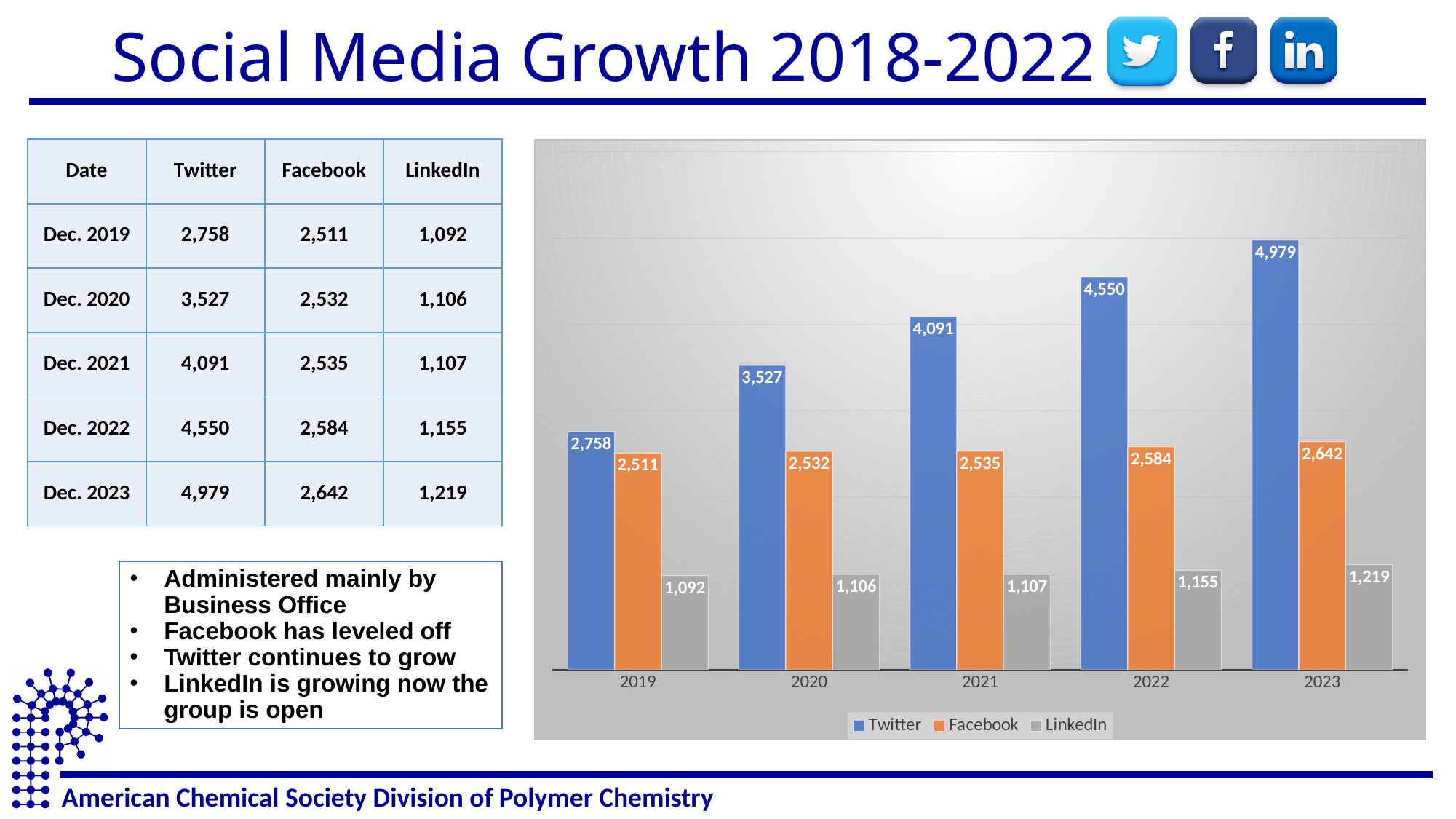
What is the Facebook value for 2020 in the chart? 2,532 Which series is shown in orange in the chart? Facebook How many series does the chart legend list? 3 In which year is the Twitter value highest? 2023 What is the LinkedIn value for 2022 in the chart? 1,155 What is the difference between the Twitter values for 2023 and 2019? 2,221 How many years are shown on the x axis of the chart? 5 Which is larger in 2021, the Twitter value or the Facebook value? Twitter In which year is the LinkedIn value lowest? 2019 Do the Twitter values rise or fall from 2019 to 2023? Rise What kind of chart is shown on the slide? Bar chart What is the Twitter value for 2023 in the chart? 4,979